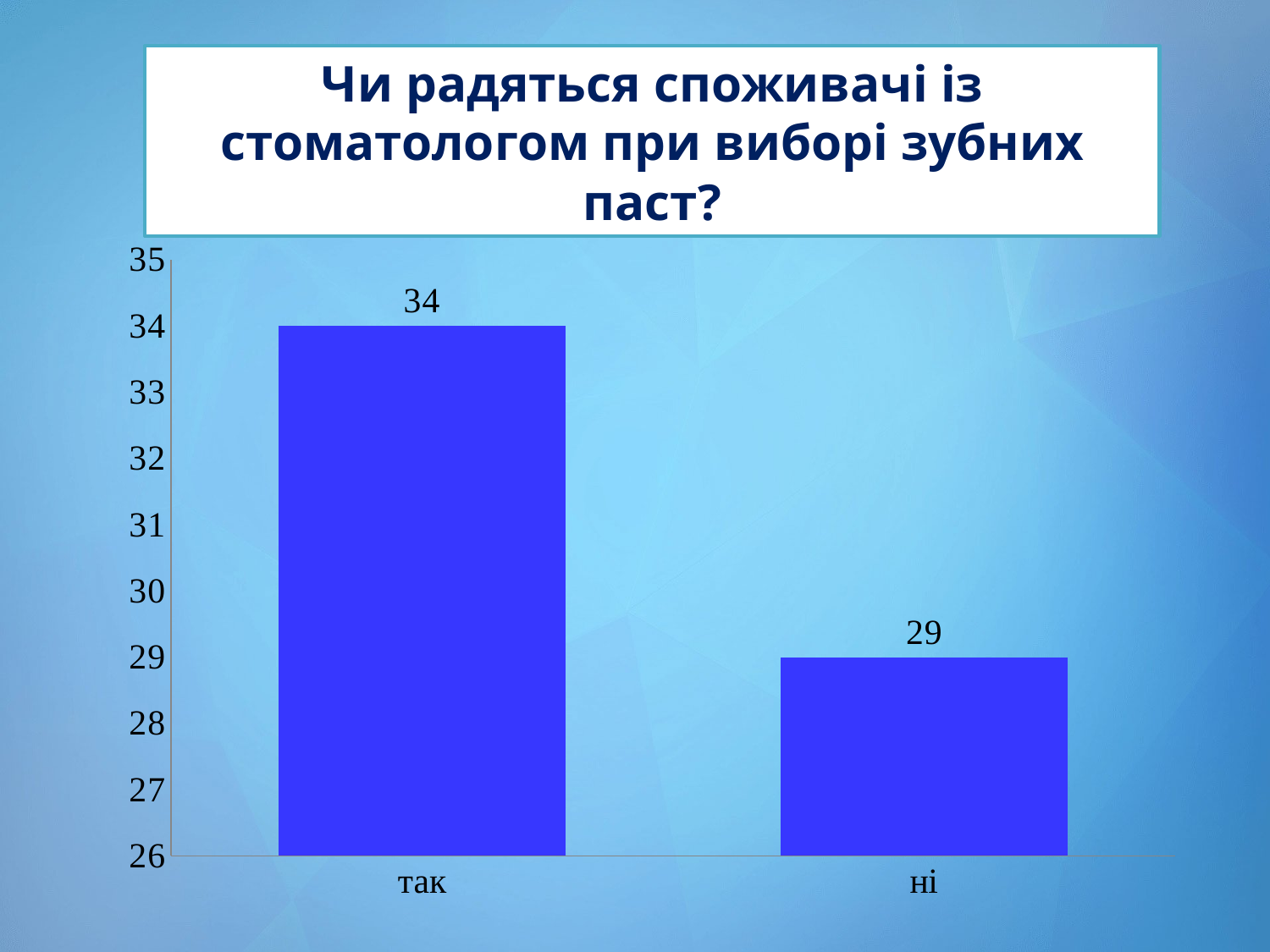
What is the lowest value shown on the y axis? 26 Is the value for "так" greater or less than 32? greater What is the value for "ні"? 29 What is the difference between the values for "так" and "ні"? 5 Which category has the highest value? так Which is larger, the value for "так" or the value for "ні"? так What is the value for "так"? 34 What is the title of the chart? Чи радяться споживачі із стоматологом при виборі зубних паст? How many categories are shown on the x axis? 2 Which category has the lowest value? ні What kind of chart is shown on the slide? bar chart Is the value for "ні" greater or less than 30? less